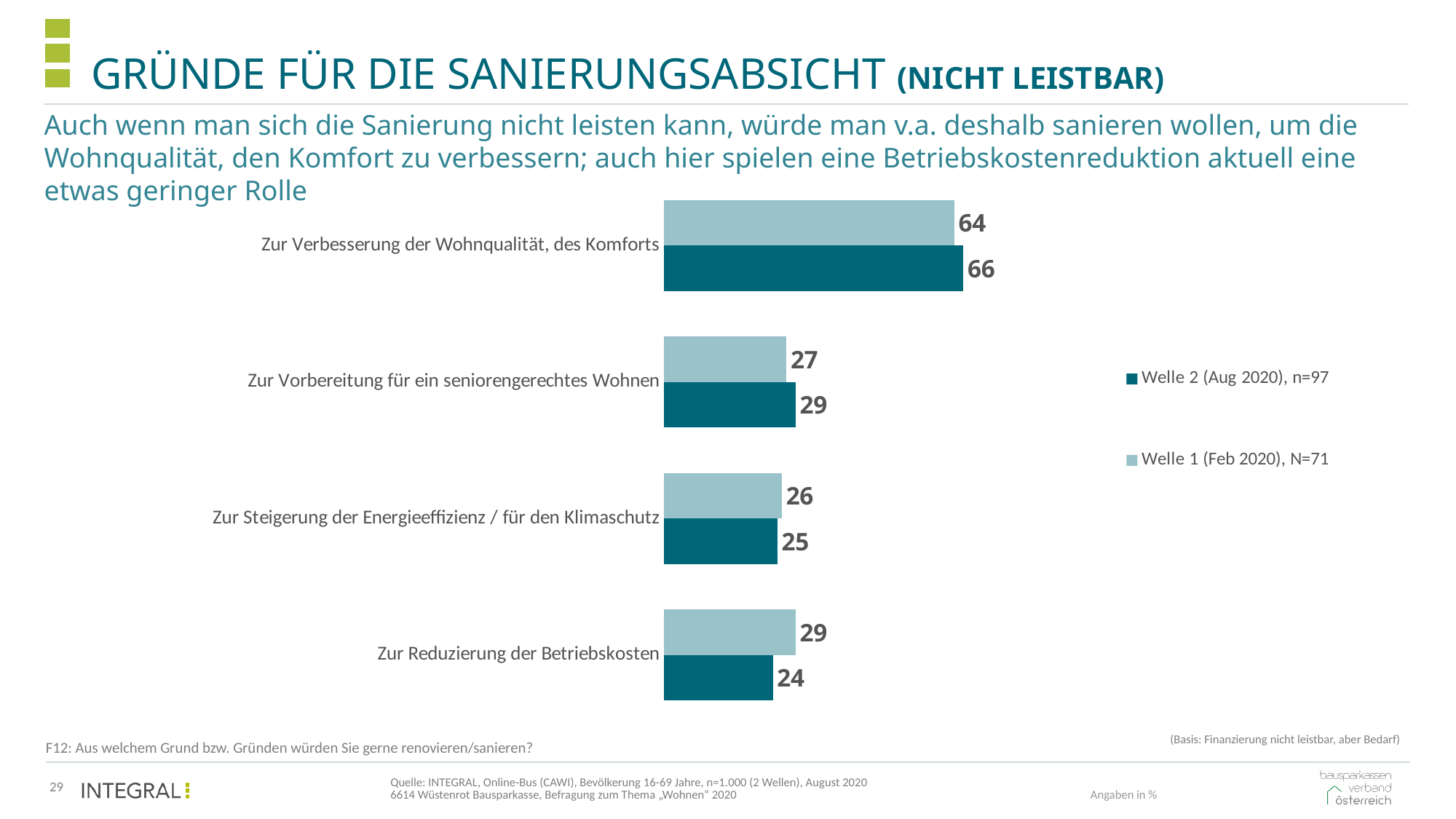
How many series does the legend list? 2 Which category has the lowest Welle 2 (Aug 2020) value? Zur Reduzierung der Betriebskosten What is the difference between the Welle 2 and Welle 1 values for "Zur Verbesserung der Wohnqualität, des Komforts"? 2 For "Zur Vorbereitung für ein seniorengerechtes Wohnen", which is larger: the Welle 1 or the Welle 2 value? Welle 2 How many categories are shown in the chart? 4 What is the sample size (n) given in the legend for Welle 2 (Aug 2020)? n=97 What is the Welle 1 (Feb 2020) value for "Zur Reduzierung der Betriebskosten"? 29 What is the difference between the Welle 1 and Welle 2 values for "Zur Reduzierung der Betriebskosten"? 5 What is the Welle 2 (Aug 2020) value for "Zur Steigerung der Energieeffizienz / für den Klimaschutz"? 25 What is the Welle 2 (Aug 2020) value for "Zur Verbesserung der Wohnqualität, des Komforts"? 66 Which category has the highest Welle 2 (Aug 2020) value? Zur Verbesserung der Wohnqualität, des Komforts What kind of chart is shown on the slide? Bar chart